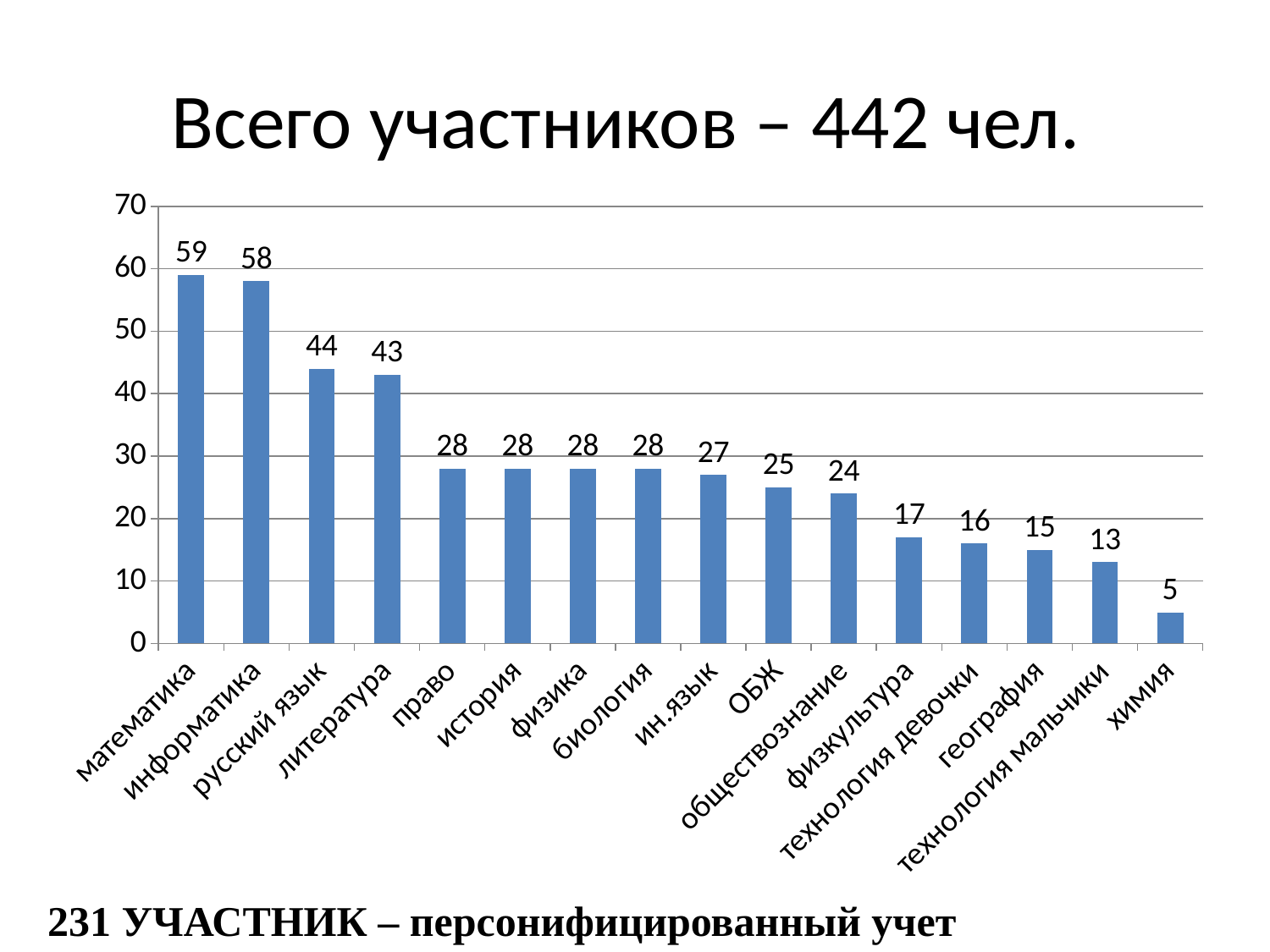
Which category has the lowest value? химия What is the difference between the values for русский язык and литература? 1 How many categories are shown on the x axis? 16 What is the value for технология мальчики? 13 What kind of chart is shown on the slide? bar chart What is the value for обществознание? 24 Which category has the highest value? математика What is the value for математика? 59 Is the value for география greater or less than 20? less What is the difference between the values for информатика and химия? 53 What is the title of the slide above the chart? Всего участников – 442 чел. Which is larger, the value for ОБЖ or the value for физкультура? ОБЖ